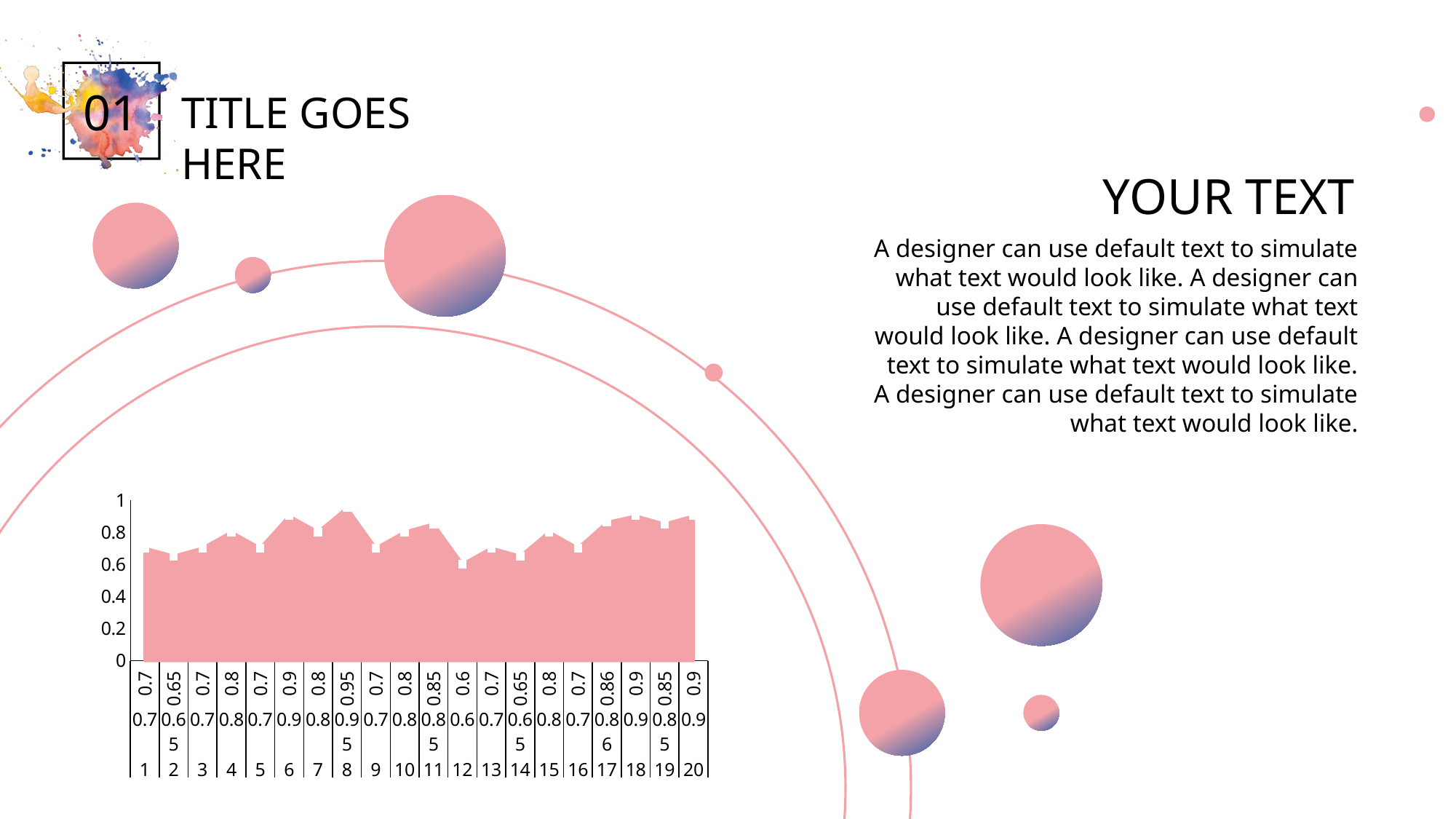
How many categories are plotted along the x axis of the chart? 20 Which category has the highest value? 8 Which category has the lowest value? 12 What is the value for category 20? 0.9 Is the value for category 2 greater or less than 0.8? less What is the difference between the values for category 8 and category 12? 0.35 What is the value for category 8? 0.95 What kind of chart is shown on the slide? area chart What is the value for category 12? 0.6 What is the highest tick value shown on the y axis? 1 What is the value for category 17? 0.86 Which is larger, the value for category 6 or the value for category 7? category 6